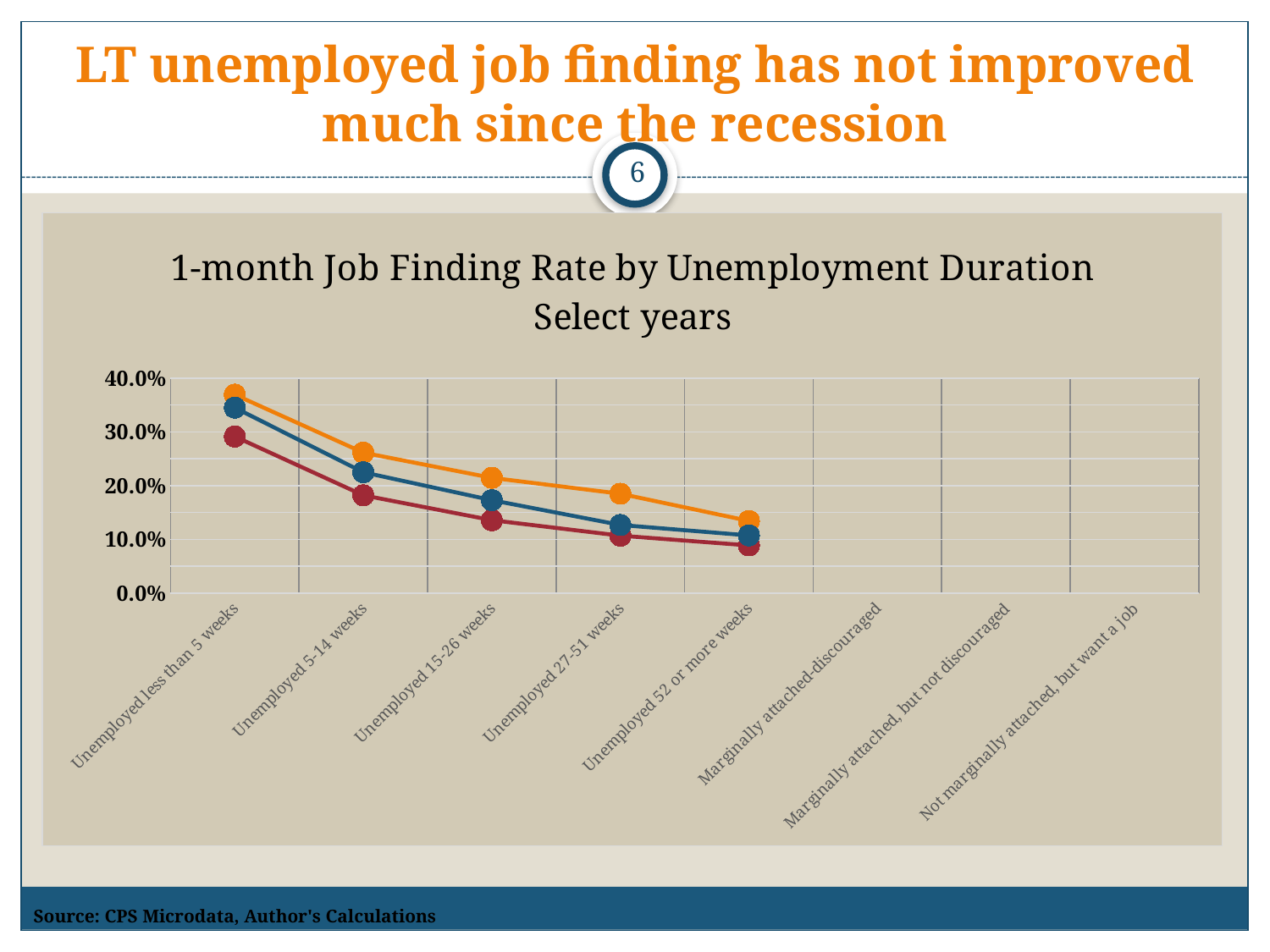
Do the values of the orange line rise or fall moving from 'Unemployed less than 5 weeks' to 'Unemployed 52 or more weeks'? Fall How many category labels are shown along the x axis of the chart? 8 For the orange line, which category has the highest value? Unemployed less than 5 weeks Is the value of the red line for 'Unemployed 5-14 weeks' greater or less than 20.0%? less How many categories have plotted data points on the chart? 5 What kind of chart is shown on the slide? Line chart For the red line, which plotted category has the lowest value? Unemployed 52 or more weeks Is the value of the orange line for 'Unemployed less than 5 weeks' greater or less than 30.0%? greater At 'Unemployed less than 5 weeks', which line has the larger value, the orange line or the red line? Orange line How many lines are plotted on the chart? 3 What is the title of the chart? 1-month Job Finding Rate by Unemployment Duration Select years